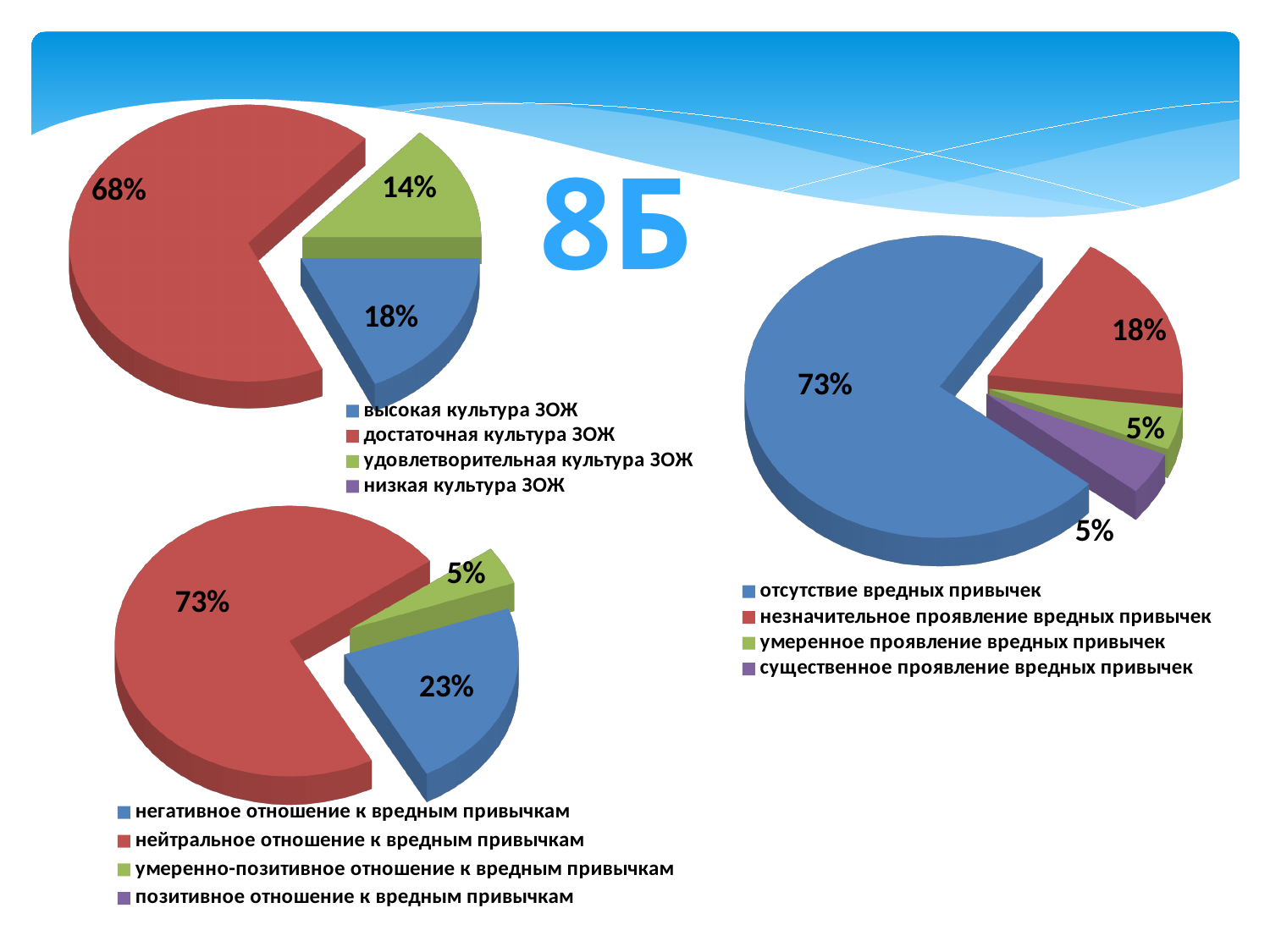
On the right pie chart, what percentage is shown for отсутствие вредных привычек? 73% What type of chart is used on the right side of the slide? pie chart On the top-left pie chart, what percentage is shown for достаточная культура ЗОЖ? 68% On the bottom-left pie chart, which is larger: негативное отношение or умеренно-позитивное отношение к вредным привычкам? негативное отношение к вредным привычкам On the top-left pie chart, which category has the largest slice? достаточная культура ЗОЖ On the right pie chart, what percentage is shown for незначительное проявление вредных привычек? 18% On the top-left pie chart, what is the difference between the shares for достаточная культура ЗОЖ and удовлетворительная культура ЗОЖ? 54% On the top-left pie chart, how many entries does the legend list? 4 On the top-left pie chart, what percentage is shown for высокая культура ЗОЖ? 18% On the bottom-left pie chart, which category has the largest slice? нейтральное отношение к вредным привычкам On the bottom-left pie chart, what percentage is shown for негативное отношение к вредным привычкам? 23% On the right pie chart, what is the difference between the shares for отсутствие вредных привычек and незначительное проявление вредных привычек? 55%